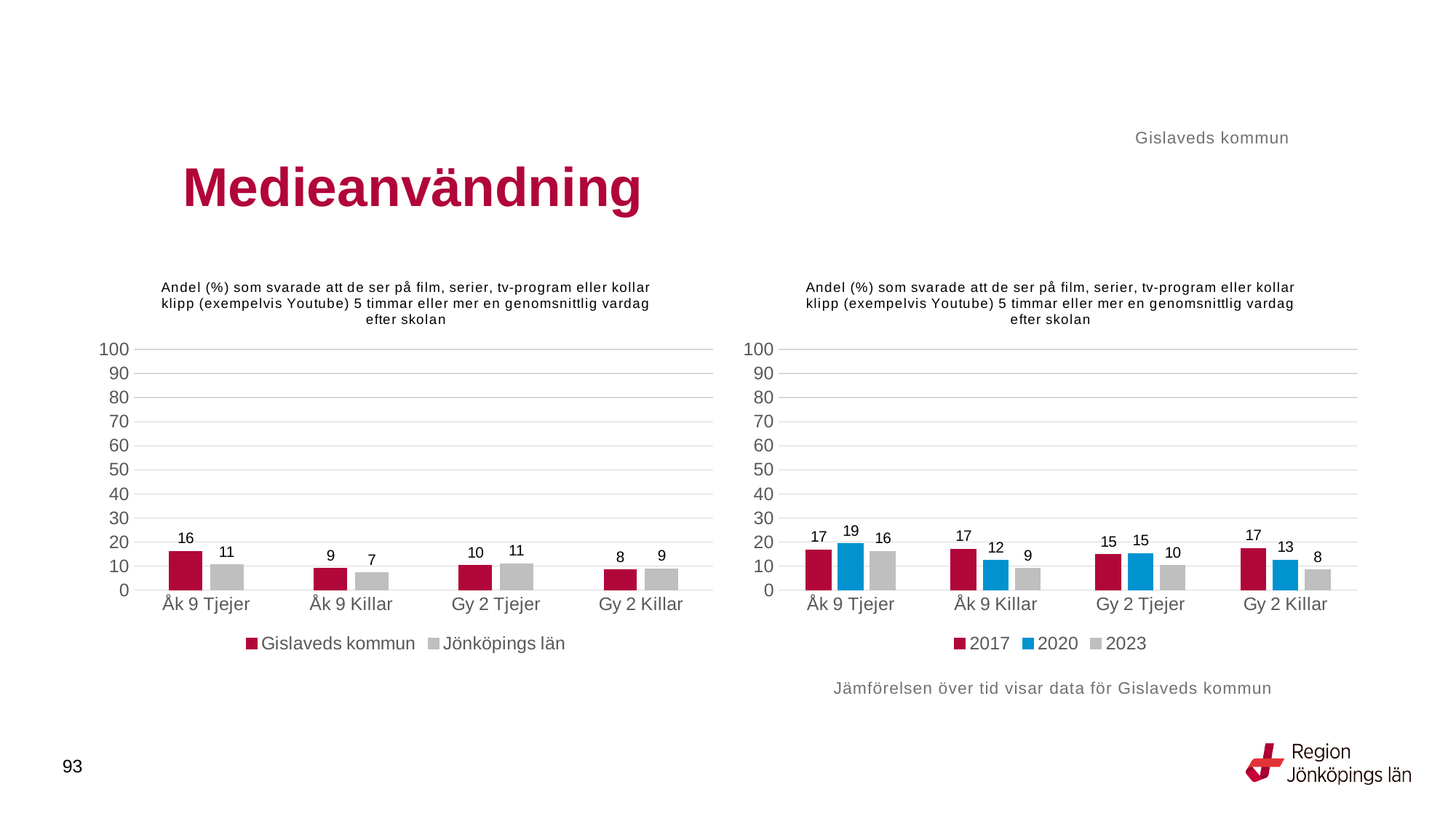
In the right chart, how many categories are shown on the x axis? 4 In the left chart, which category has the highest value for Gislaveds kommun? Åk 9 Tjejer In the left chart, what is the value for Jönköpings län for Gy 2 Killar? 9 In the right chart, what is the difference between 2017 and 2023 for Gy 2 Killar? 9 In the left chart, what is the difference between Gislaveds kommun and Jönköpings län for Åk 9 Tjejer? 5 In the left chart, how many series does the legend list? 2 In the left chart, what is the value for Gislaveds kommun for Åk 9 Tjejer? 16 In the right chart, which is larger for Åk 9 Killar: 2017 or 2023? 2017 In the left chart, which category has the lowest value for Jönköpings län? Åk 9 Killar What type of chart is the right chart? Bar chart In the right chart, what is the value for 2023 for Gy 2 Killar? 8 In the right chart, what is the value for 2020 for Åk 9 Tjejer? 19